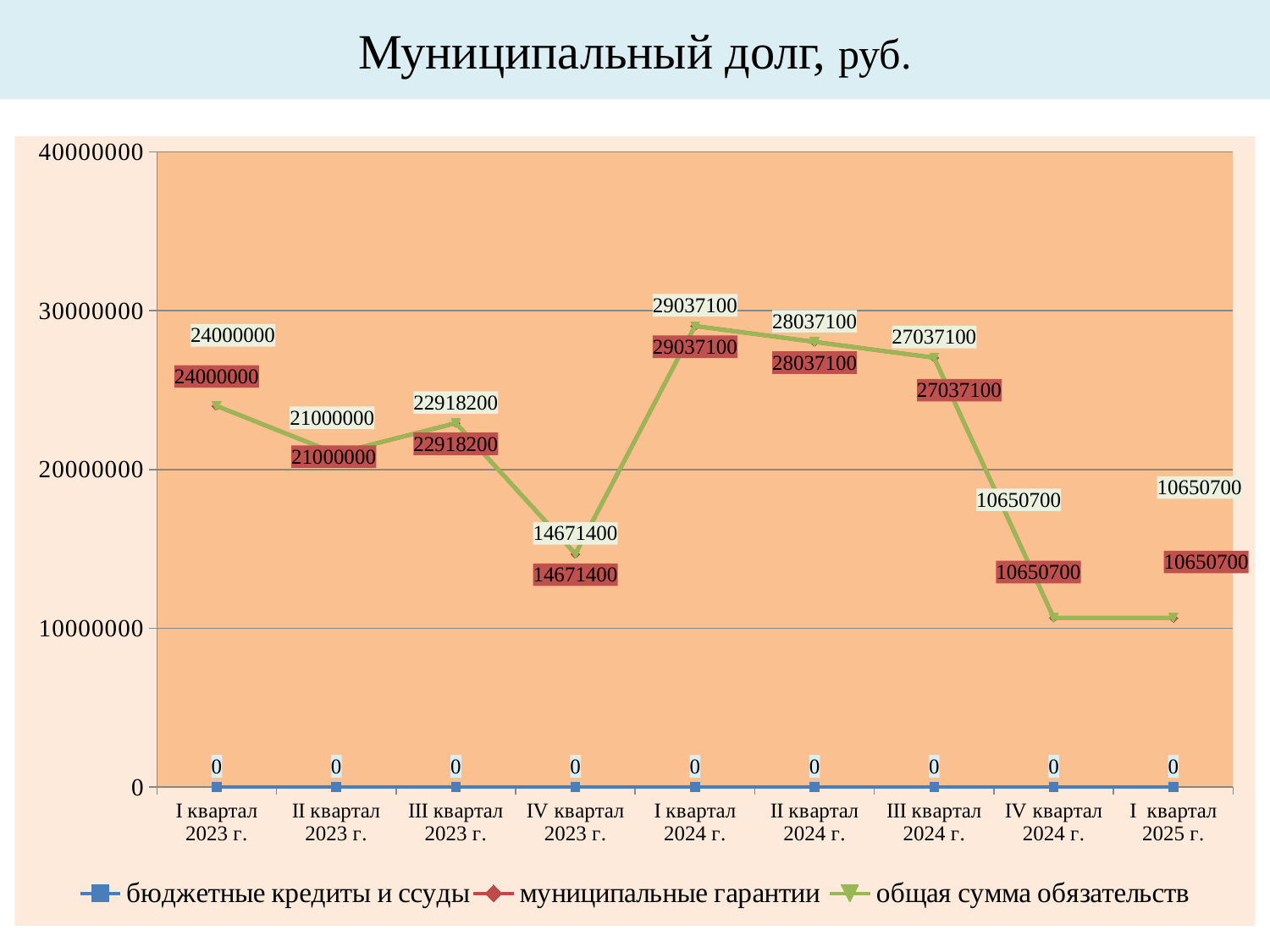
What is the value of общая сумма обязательств for I квартал 2024 г.? 29037100 What is the lowest value of общая сумма обязательств shown on the chart? 10650700 What is the title of the chart? Муниципальный долг, руб. What is the difference between общая сумма обязательств in I квартал 2024 г. and II квартал 2024 г.? 1000000 What is the value of муниципальные гарантии for IV квартал 2023 г.? 14671400 Which is larger, общая сумма обязательств in I квартал 2023 г. or in III квартал 2023 г.? I квартал 2023 г. How many quarters are shown on the x axis? 9 How many series does the legend list? 3 In which quarter is общая сумма обязательств highest? I квартал 2024 г. What is the value of бюджетные кредиты и ссуды for II квартал 2024 г.? 0 What kind of chart is shown on the slide? line chart Is the value of общая сумма обязательств for IV квартал 2024 г. greater or less than 20000000? less